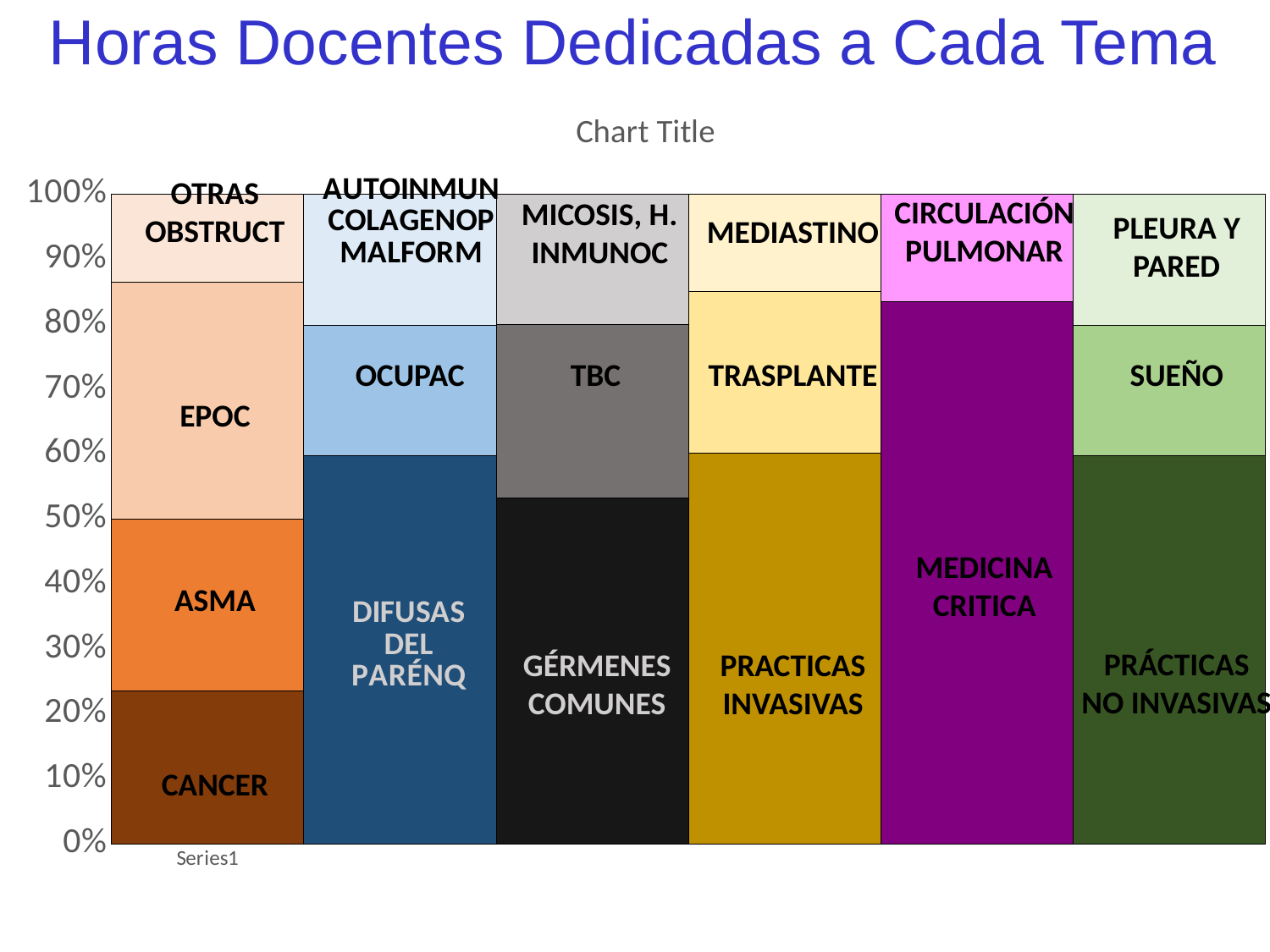
Which bottom segment occupies the smallest share of its bar? CANCER What label appears on the horizontal axis below the first bar? Series1 Is the top of the MEDICINA CRITICA segment greater or less than 80%? greater How many stacked bars does the chart contain? 6 What is the title printed above the chart area? Chart Title How many segments make up the bar that contains MEDICINA CRITICA? 2 Is the top of the CANCER segment greater or less than 30%? less What kind of chart is shown on the slide? stacked bar chart What percentage does each stacked bar total at the top of the axis? 100% Which segment is larger, CANCER or GÉRMENES COMUNES? GÉRMENES COMUNES How many segments make up the first (leftmost) bar, which starts with CANCER? 4 Which bottom segment occupies the largest share of its bar? MEDICINA CRITICA